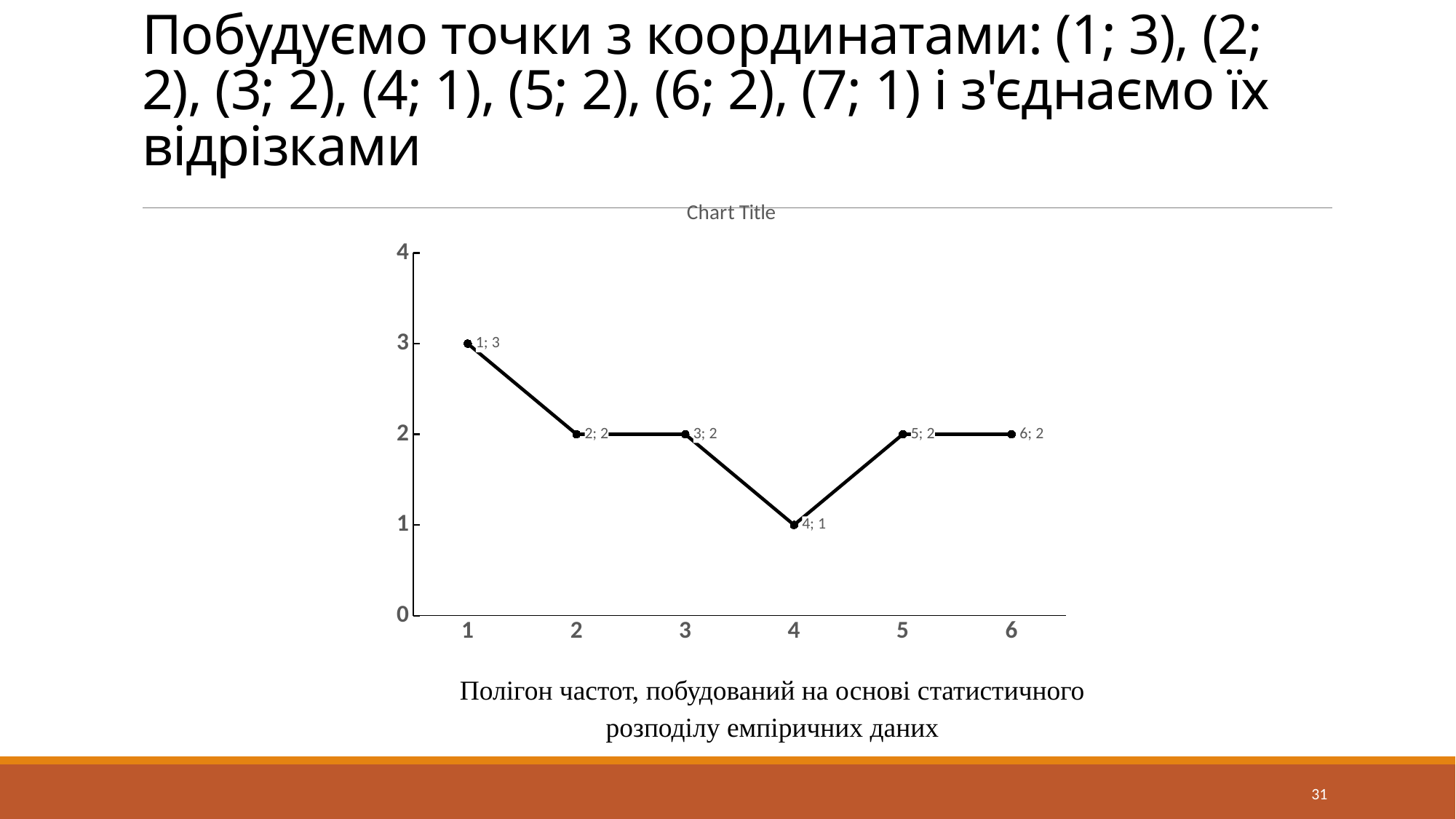
What is the value at x = 6? 2 What is the title shown above the chart? Chart Title Which is larger, the value at x = 1 or the value at x = 2? x = 1 What is the value at x = 1? 3 Does the line rise or fall between x = 1 and x = 2? fall At which x value is the plotted value lowest? 4 Does the line rise or fall between x = 4 and x = 5? rise How many data points are plotted on the chart? 6 What is the difference between the values at x = 1 and x = 4? 2 What type of chart is shown on the slide? line chart At which x value is the plotted value highest? 1 What is the value at x = 4? 1